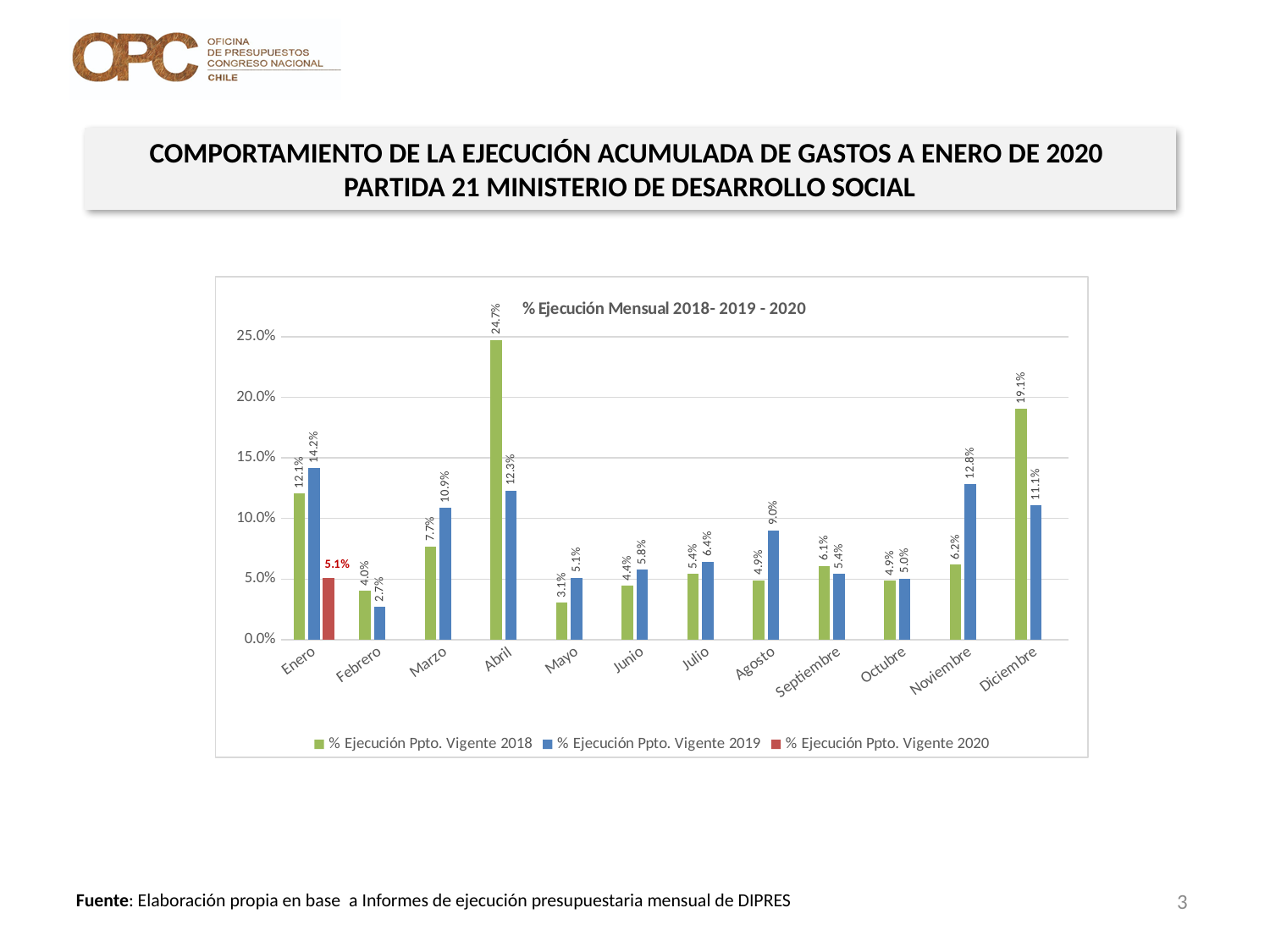
What kind of chart is shown on the slide? Bar chart How many months are shown on the x axis? 12 What is the title of the chart? % Ejecución Mensual 2018- 2019 - 2020 What is the value for % Ejecución Ppto. Vigente 2018 in Abril? 24.7% Which month has the lowest value for % Ejecución Ppto. Vigente 2019? Febrero In Agosto, which series is larger: % Ejecución Ppto. Vigente 2018 or % Ejecución Ppto. Vigente 2019? % Ejecución Ppto. Vigente 2019 What is the difference between the 2018 and 2019 values in Diciembre? 8.0% Is the value for % Ejecución Ppto. Vigente 2019 in Marzo greater or less than 10.0%? greater What is the value for % Ejecución Ppto. Vigente 2020 in Enero? 5.1% What is the value for % Ejecución Ppto. Vigente 2019 in Noviembre? 12.8% Which month has the highest value for % Ejecución Ppto. Vigente 2018? Abril How many series does the legend list? 3